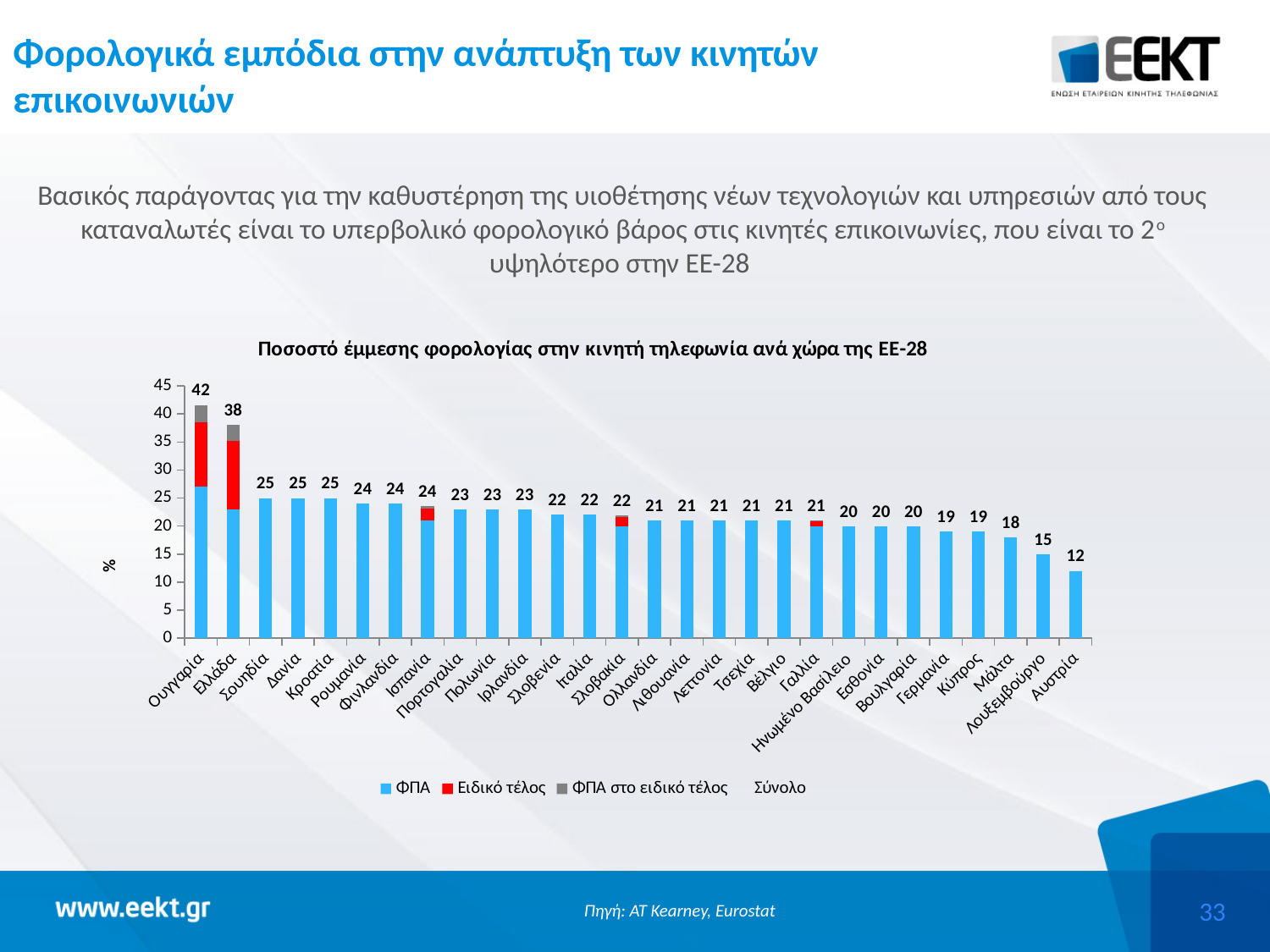
Which has a higher total, Μάλτα or Λουξεμβούργο? Μάλτα How many entries does the legend list? 4 Which country has the lowest total indirect tax percentage? Αυστρία Do the total values rise or fall from left to right along the x axis? Fall Which country has the highest total indirect tax percentage? Ουγγαρία What is the total value shown for Αυστρία? 12 What kind of chart is shown on the slide? Stacked bar chart What is the total indirect tax percentage shown for Ουγγαρία? 42 What is the total value shown for Ελλάδα? 38 How many countries are shown on the x axis? 28 Is the ΦΠΑ value for Ουγγαρία greater or less than 20? greater What is the difference between the totals for Ουγγαρία and Ελλάδα? 4